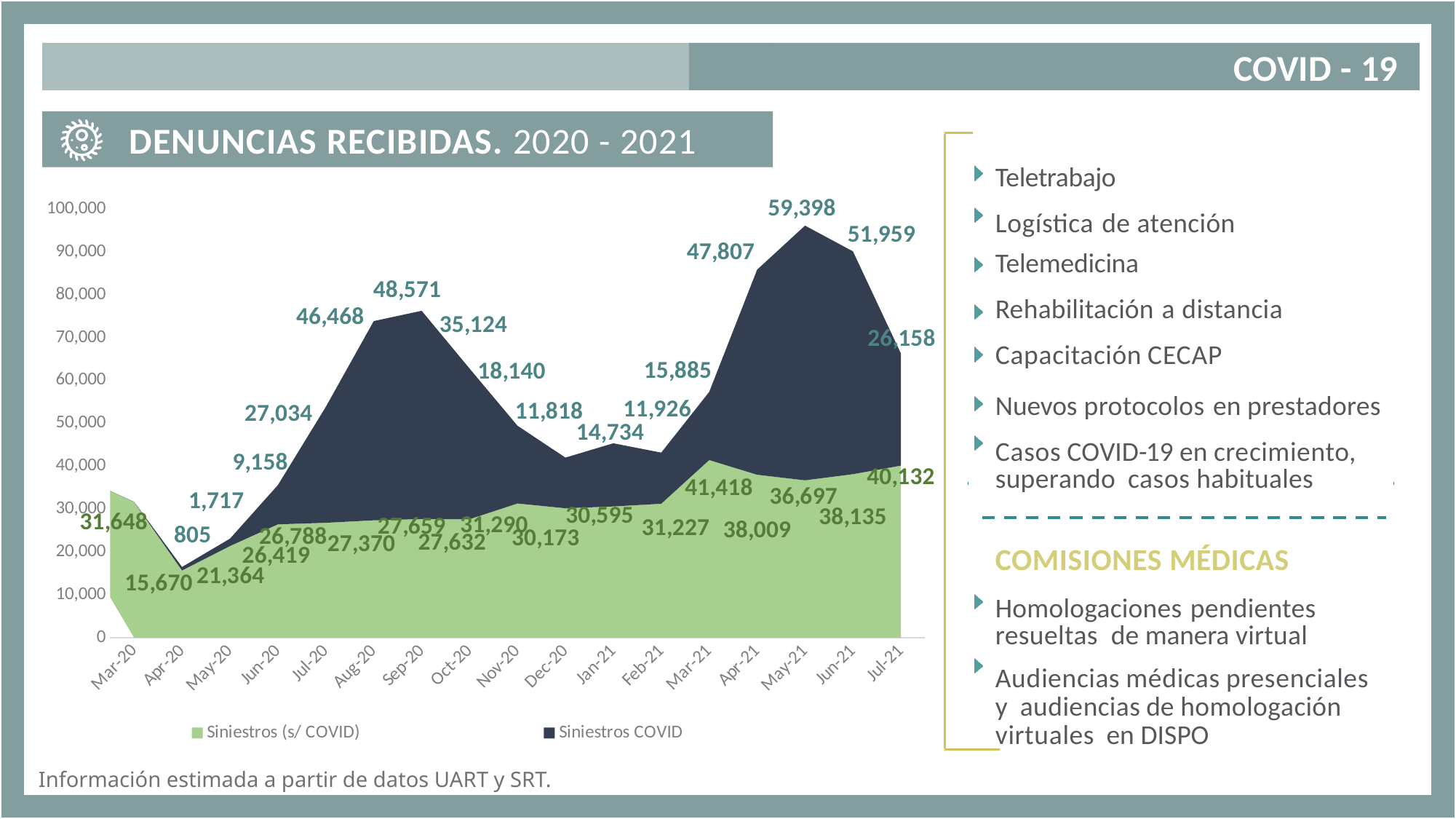
What is the combined total of both series for May-21? 96,095 Is the combined total of both series for Sep-20 greater or less than 70,000? greater What is the value of Siniestros COVID for Jul-21? 26,158 In which month is Siniestros COVID highest? May-21 What is the difference between Siniestros COVID in May-21 and Jun-21? 7,439 What is the value of Siniestros (s/ COVID) for Apr-20? 15,670 What is the value of Siniestros COVID for May-21? 59,398 How many months are plotted along the x axis? 17 How many series does the legend list? 2 In which month is Siniestros (s/ COVID) highest? Mar-21 In which month is Siniestros (s/ COVID) lowest? Apr-20 What kind of chart is shown on the slide? Stacked area chart